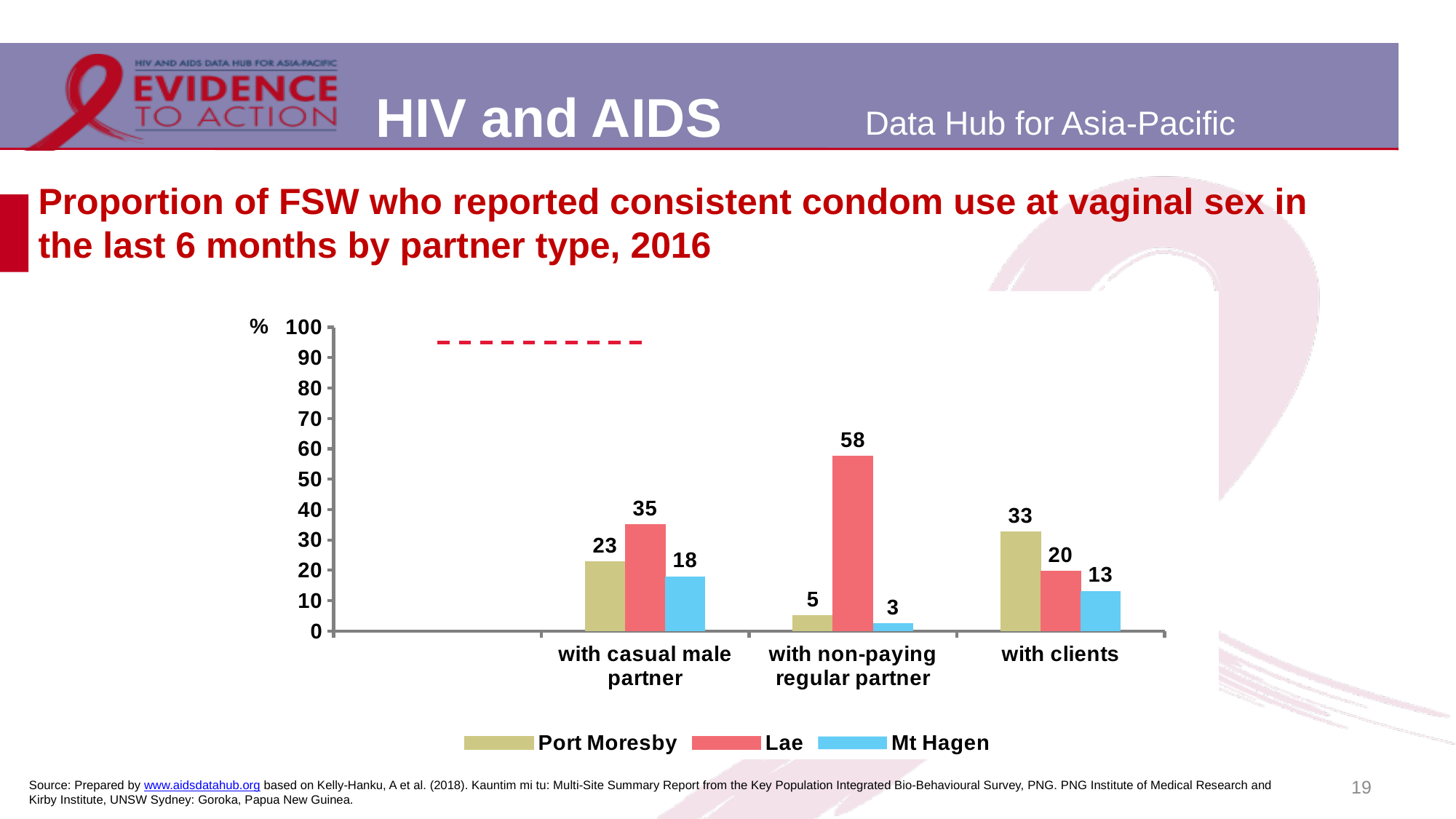
What kind of chart is shown on the slide? bar chart What is the difference between Lae and Port Moresby with casual male partner? 12 Which colour represents Mt Hagen in the legend? blue Which city has the highest value with non-paying regular partner? Lae What is the value for Lae with non-paying regular partner? 58 How many partner type categories are shown on the x axis? 3 How many series does the legend list? 3 What is the value for Mt Hagen with casual male partner? 18 What is the value for Port Moresby with clients? 33 Which is larger: Port Moresby with clients or Lae with clients? Port Moresby with clients Is the value for Lae with non-paying regular partner greater or less than 50? greater Which city has the lowest value with clients? Mt Hagen